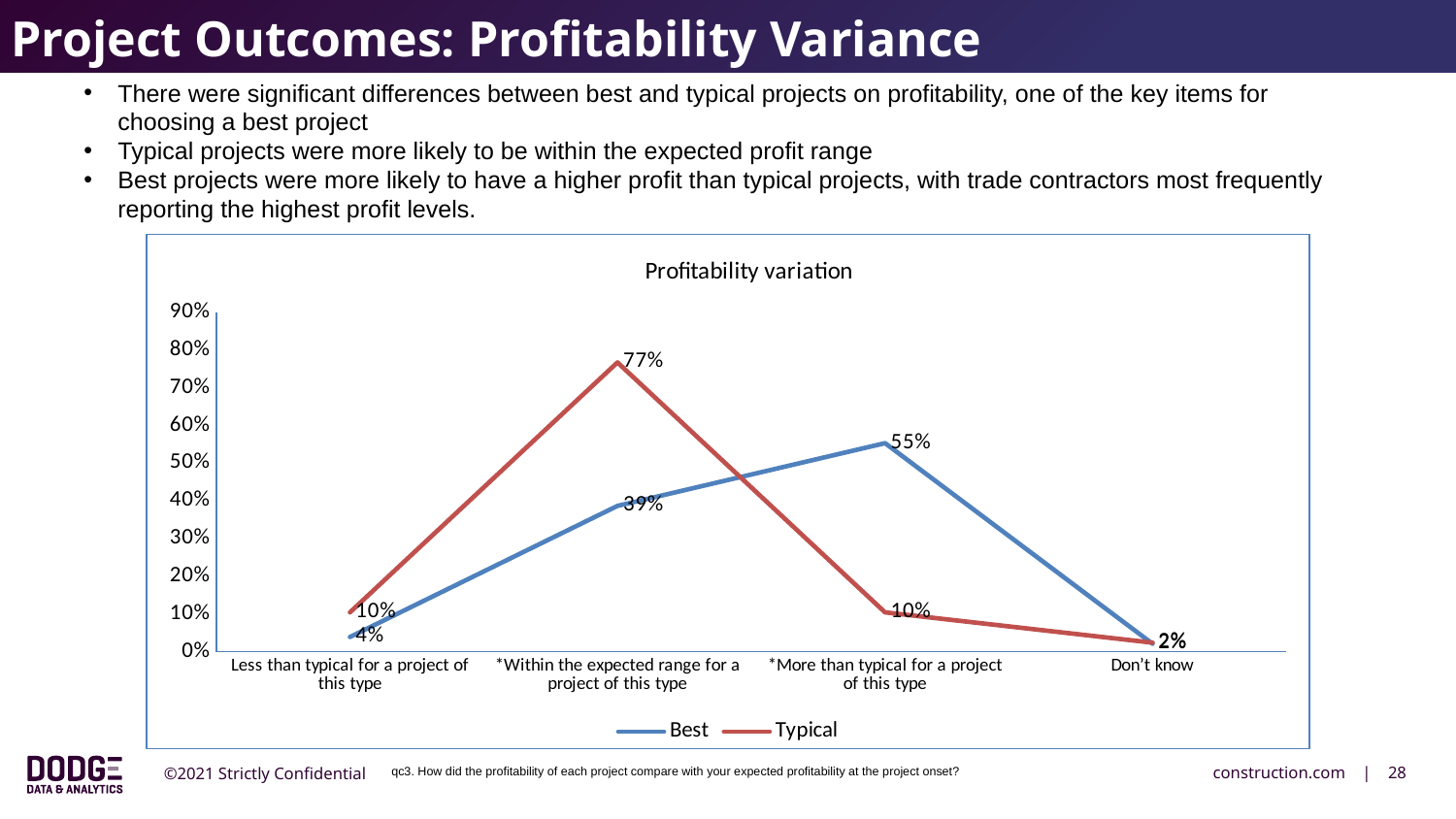
What type of chart is shown on the slide? line chart What is the value for Typical for 'Within the expected range for a project of this type'? 77% Which category has the highest value for the Best series? *More than typical for a project of this type What is the title of the chart? Profitability variation What is the difference between Typical and Best for 'Within the expected range for a project of this type'? 38% How many series does the legend list? 2 What is the value for Best for 'Within the expected range for a project of this type'? 39% For 'More than typical for a project of this type', which series has the larger value, Best or Typical? Best How many categories are shown on the x axis? 4 What is the value for Best for 'More than typical for a project of this type'? 55% What is the value for Typical for 'Less than typical for a project of this type'? 10% Which category has the highest value for the Typical series? *Within the expected range for a project of this type